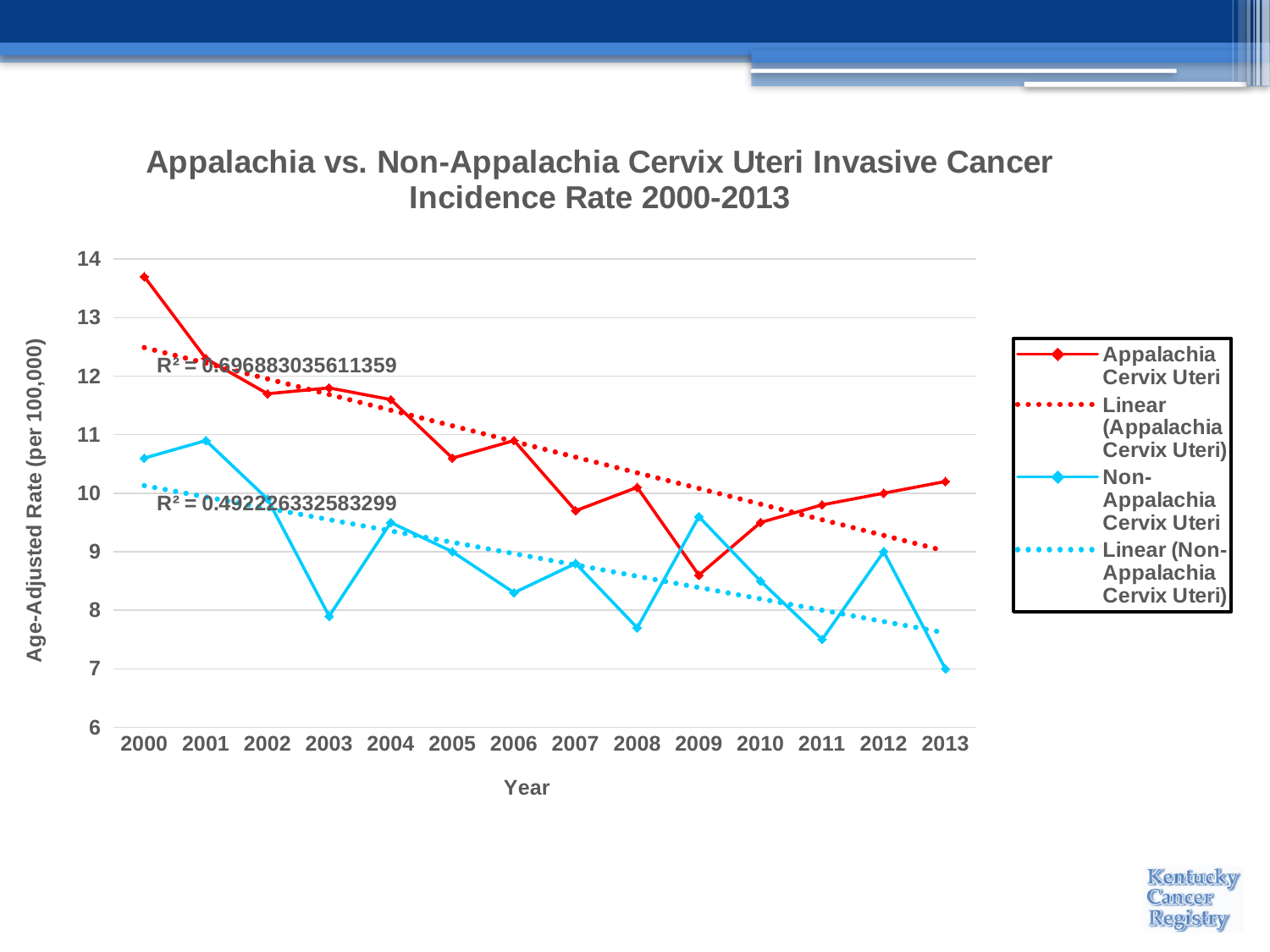
In which year is the Non-Appalachia Cervix Uteri rate lowest? 2013 In 2000, which series has the higher rate, Appalachia Cervix Uteri or Non-Appalachia Cervix Uteri? Appalachia Cervix Uteri How many entries does the legend list? 4 What is the R² value shown for the Appalachia Cervix Uteri trendline? 0.696883035611359 Is the Appalachia Cervix Uteri value for 2000 greater or less than 13? greater In which year is the Appalachia Cervix Uteri rate highest? 2000 Does the Appalachia Cervix Uteri linear trendline rise or fall from 2000 to 2013? fall What kind of chart is shown on the slide? line chart Is the Appalachia Cervix Uteri value for 2009 greater or less than 9? less Is the Non-Appalachia Cervix Uteri value for 2001 greater or less than 10? greater How many years are plotted along the x axis? 14